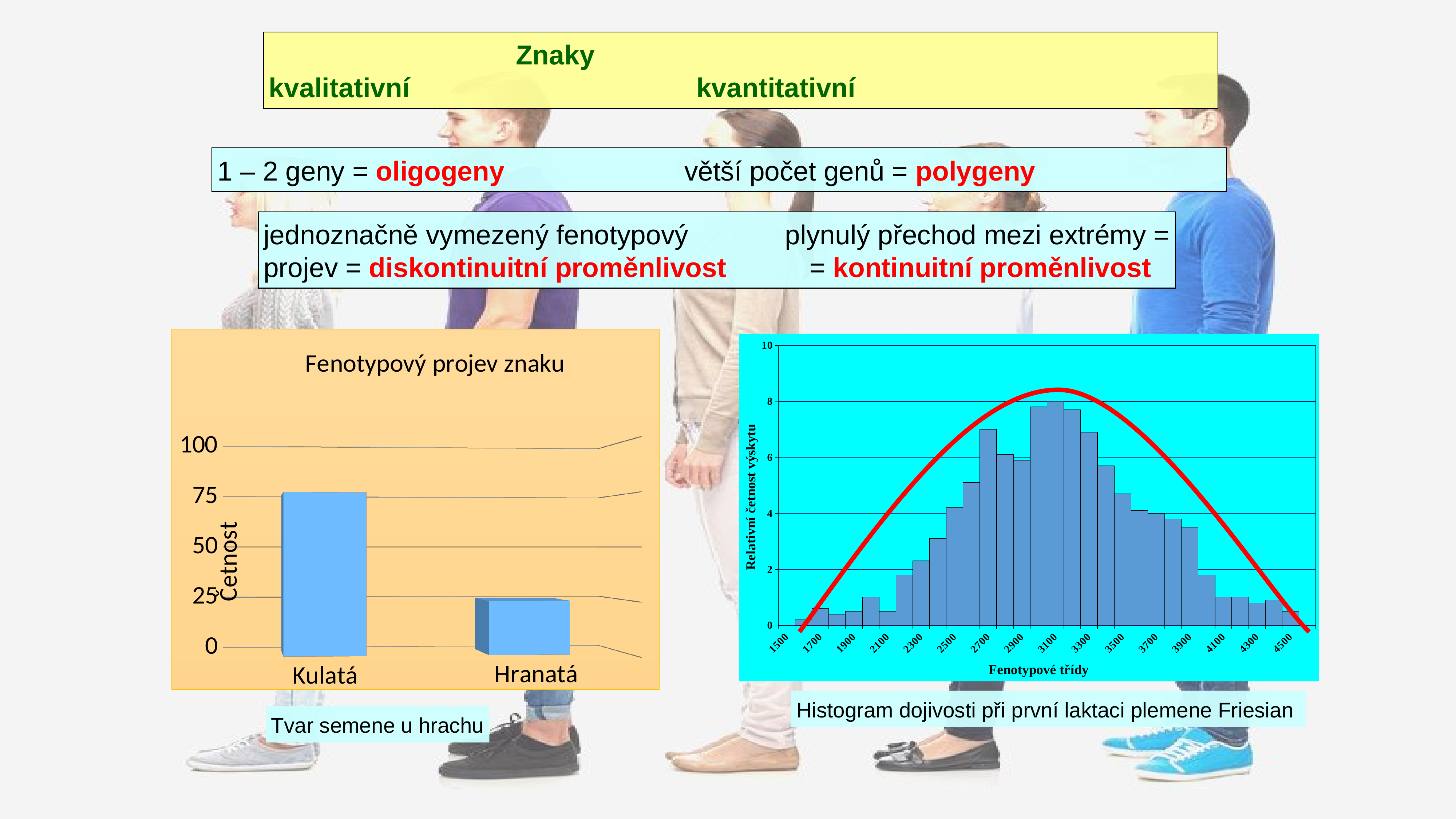
What kind of chart is the 'Fenotypový projev znaku' chart on the left? bar chart What is the x-axis label of the histogram on the right? Fenotypové třídy What kind of chart is the histogram on the right of the slide? bar chart In the histogram on the right, is the value for the 1700 class greater or less than 2? less In the 'Fenotypový projev znaku' chart, is the value for Kulatá greater or less than 50? greater What is the y-axis label of the 'Fenotypový projev znaku' chart? Četnost In the 'Fenotypový projev znaku' chart, which category has the lowest value? Hranatá In the 'Fenotypový projev znaku' chart, how many categories are shown on the x axis? 2 In the 'Fenotypový projev znaku' chart, is the value for Hranatá greater or less than 50? less In the 'Fenotypový projev znaku' chart, which is larger, the value for Kulatá or the value for Hranatá? Kulatá In the 'Fenotypový projev znaku' chart, which category has the highest value? Kulatá